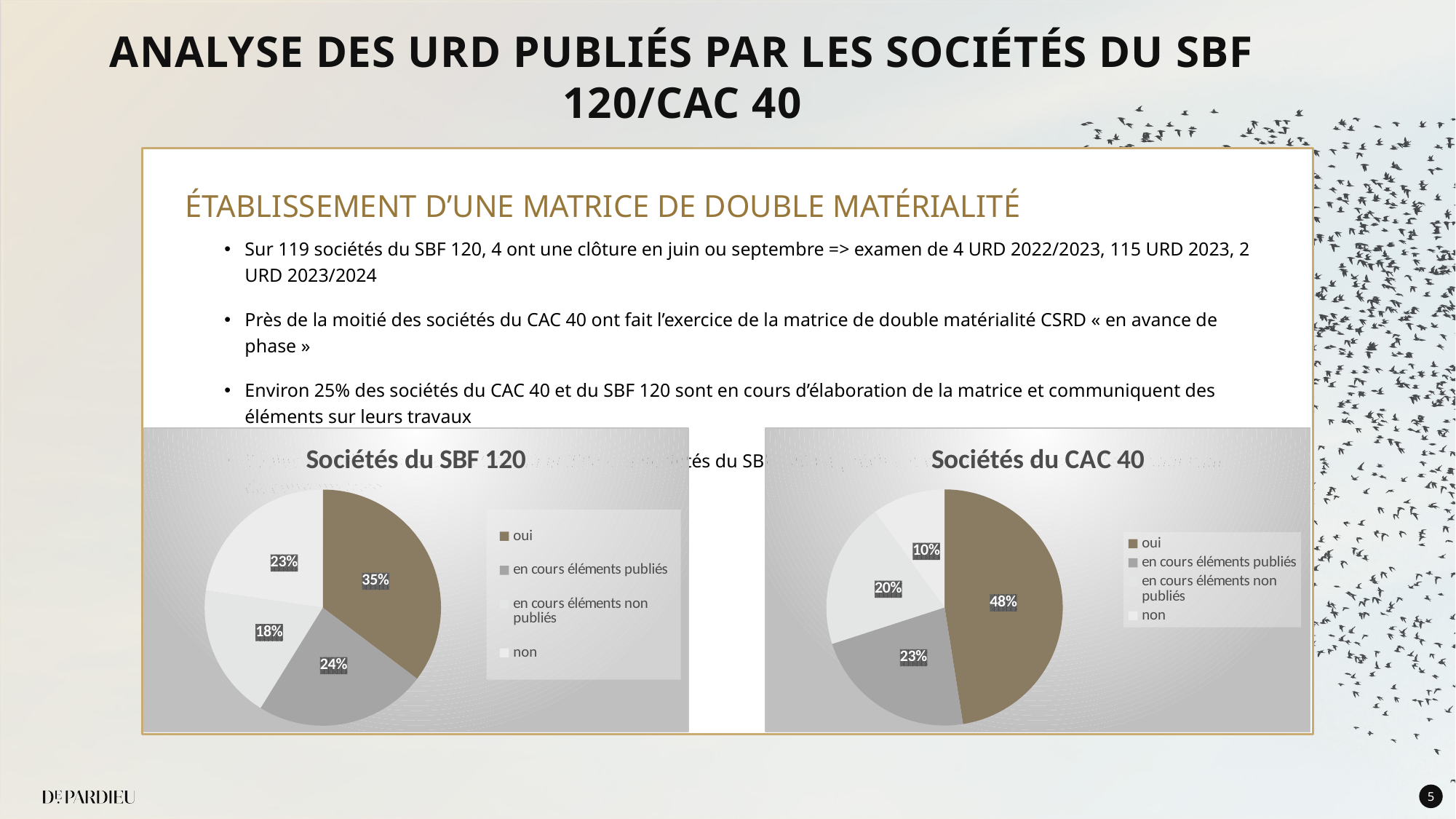
In the 'Sociétés du SBF 120' chart, what percentage is shown for 'non'? 23% In the 'Sociétés du SBF 120' chart, which category has the smallest share? en cours éléments non publiés What type of chart is 'Sociétés du SBF 120'? Pie chart In the 'Sociétés du CAC 40' chart, what percentage is shown for 'en cours éléments publiés'? 23% How many categories does the legend of the 'Sociétés du CAC 40' chart list? 4 In the 'Sociétés du SBF 120' chart, what percentage is shown for 'oui'? 35% In the 'Sociétés du CAC 40' chart, which category has the smallest share? non In the 'Sociétés du SBF 120' chart, which is larger: 'en cours éléments publiés' or 'non'? en cours éléments publiés In the 'Sociétés du CAC 40' chart, what percentage is shown for 'non'? 10% What is the difference between the 'oui' share in the 'Sociétés du CAC 40' chart and the 'oui' share in the 'Sociétés du SBF 120' chart? 13 percentage points In the 'Sociétés du CAC 40' chart, what percentage is shown for 'oui'? 48% In the 'Sociétés du SBF 120' chart, which category has the largest share? oui